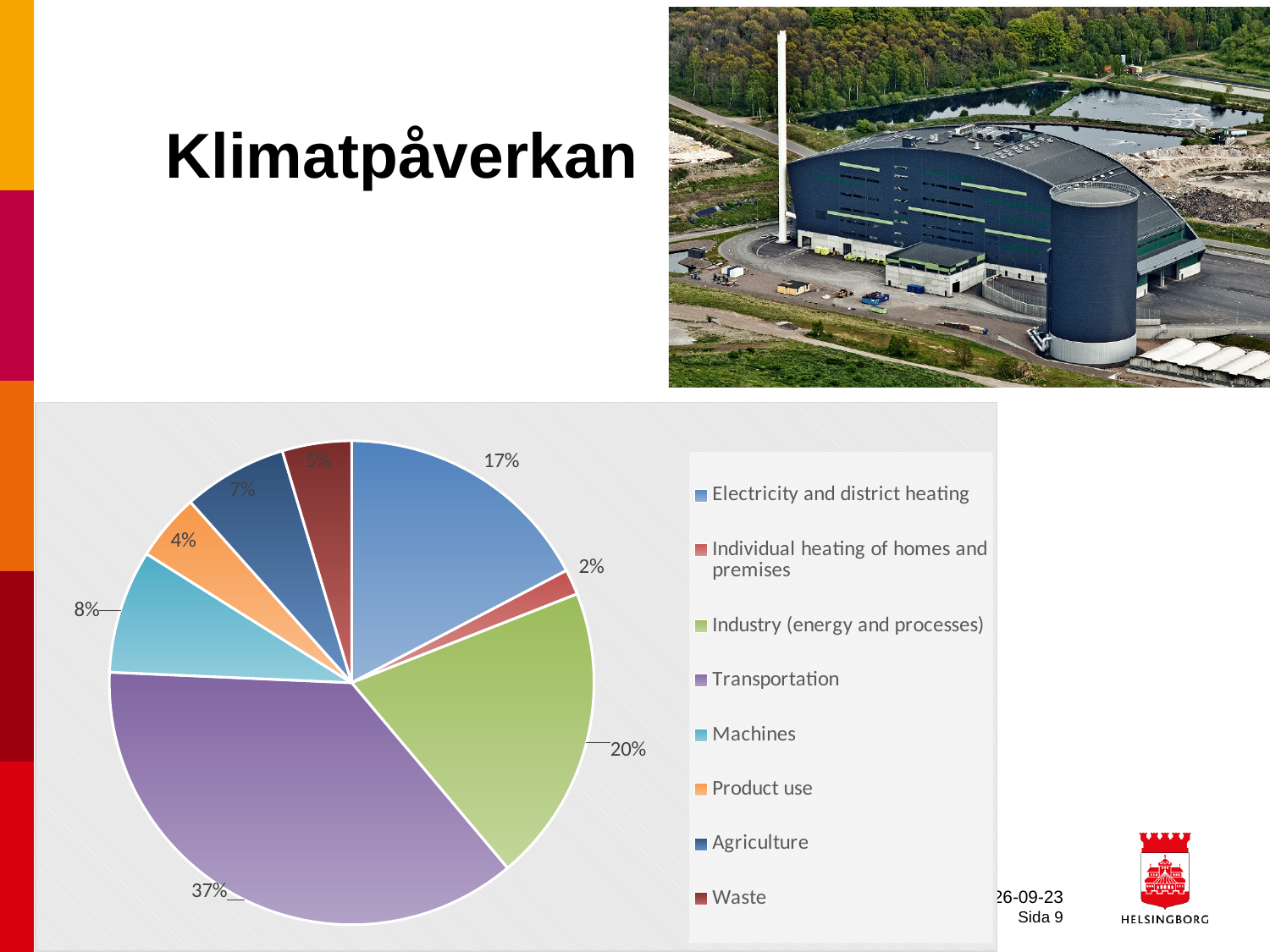
Which is larger, the share for Agriculture or the share for Product use? Agriculture What is the value shown for Machines? 8% What is the value shown for Electricity and district heating? 17% What is the difference between the Transportation share and the Industry (energy and processes) share? 17% What is the value shown for Industry (energy and processes)? 20% What share of the pie does Transportation account for? 37% What is the value shown for Individual heating of homes and premises? 2% Which category has the largest slice of the pie? Transportation Which category has the smallest slice of the pie? Individual heating of homes and premises How many categories does the legend list? 8 What colour is the Waste slice in the pie chart? dark red What kind of chart is shown on the slide? pie chart